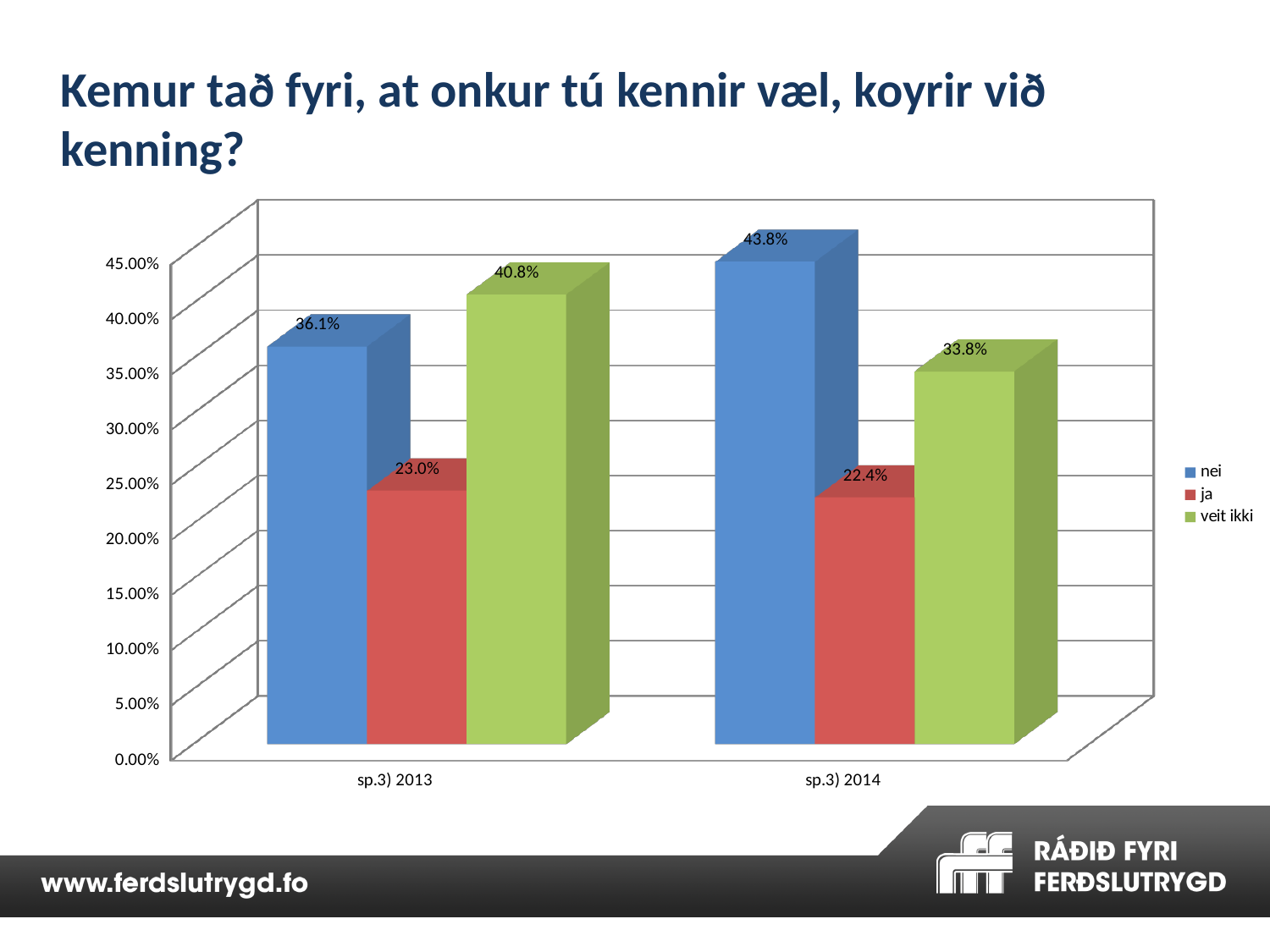
Which is larger: "veit ikki" in sp.3) 2013 or "veit ikki" in sp.3) 2014? sp.3) 2013 What is the value for "nei" in sp.3) 2013? 36.1% Which series has the lowest value in sp.3) 2013? ja How many series does the legend list? 3 How many categories are shown on the x axis? 2 What kind of chart is shown on the slide? bar chart What is the difference between the "nei" values for sp.3) 2014 and sp.3) 2013? 7.7% Which series has the highest value in sp.3) 2014? nei Does the "ja" value rise or fall from sp.3) 2013 to sp.3) 2014? fall What is the value for "veit ikki" in sp.3) 2013? 40.8% What is the value for "ja" in sp.3) 2014? 22.4% What colour are the bars for the "veit ikki" series? green